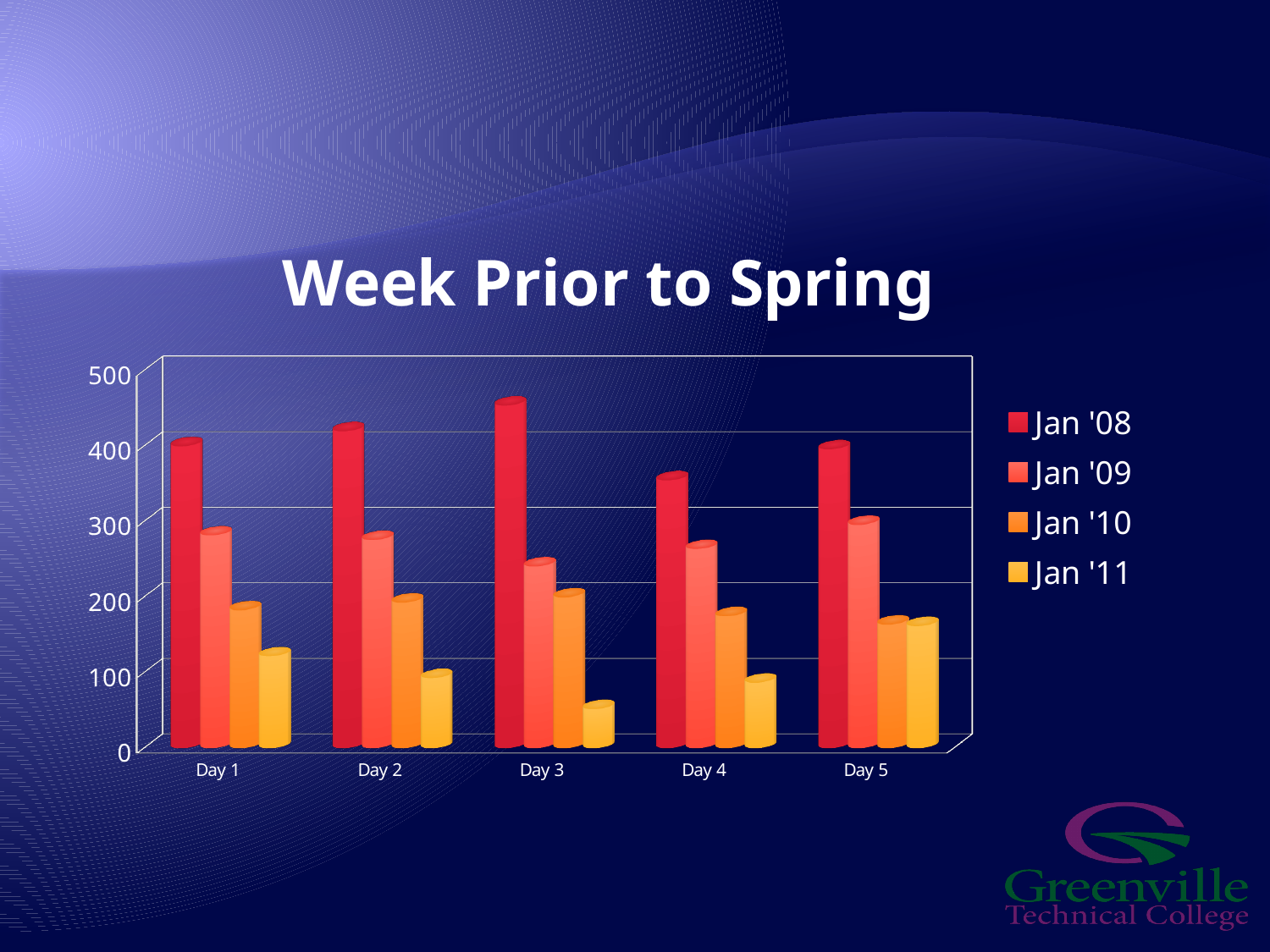
How many series does the legend list? 4 On which day is the Jan '08 value highest? Day 3 What is the title of the chart? Week Prior to Spring Is the value for Jan '08 on Day 4 greater or less than 400? less Is the value for Jan '10 on Day 5 greater or less than 100? greater How many day categories are shown on the x axis? 5 Is the value for Jan '08 on Day 3 greater or less than 400? greater On Day 1, which is larger: the Jan '08 value or the Jan '11 value? Jan '08 What kind of chart is shown on the slide? bar chart On which day is the Jan '11 value lowest? Day 3 Which series is listed first in the legend? Jan '08